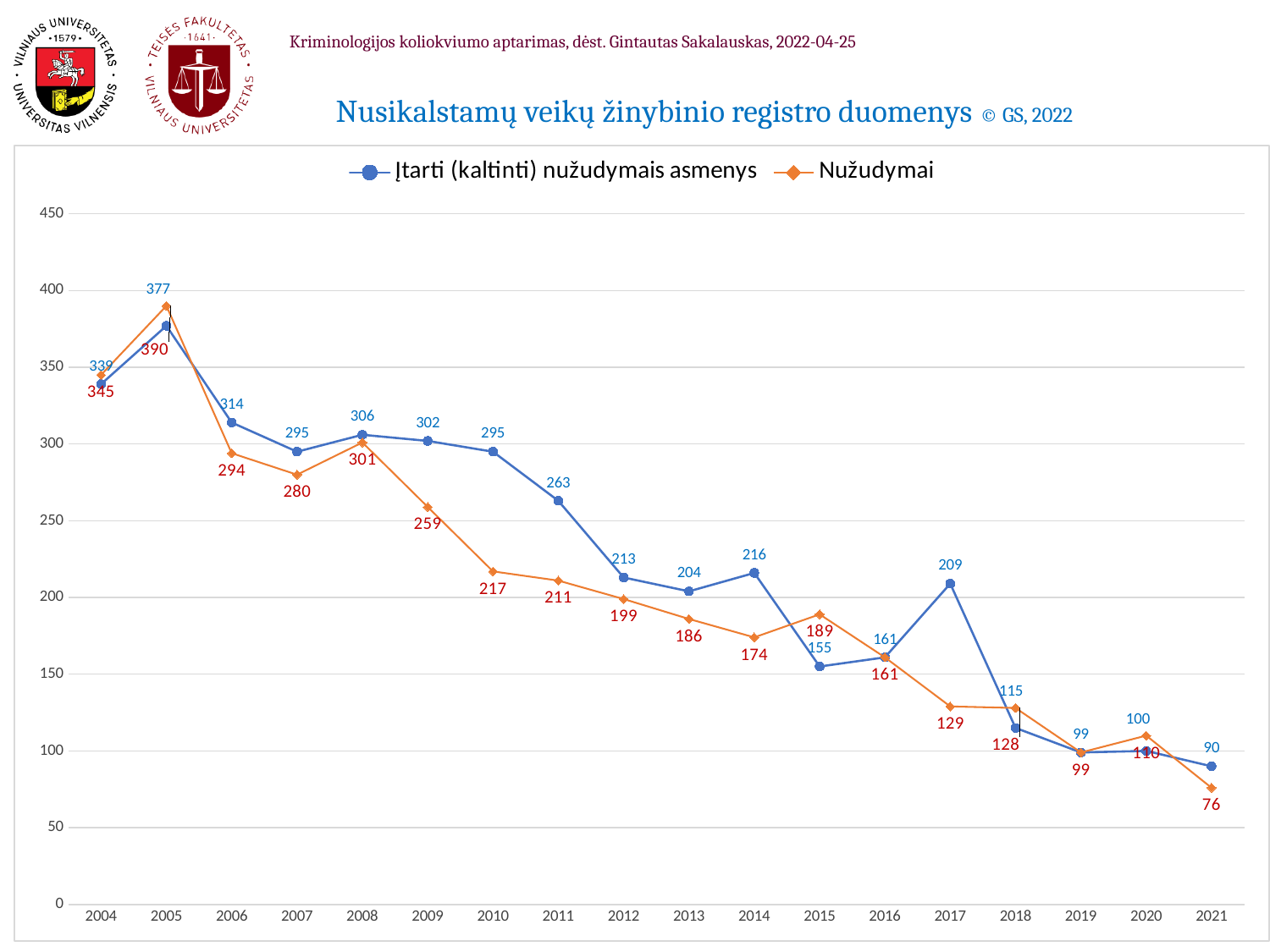
Which series has the larger value in 2015? Nužudymai What kind of chart is shown on the slide? Line chart How many series does the legend list? 2 Overall, do the values of the Nužudymai series rise or fall from 2005 to 2021? Fall How many years are shown on the x axis? 18 What is the value of the Įtarti (kaltinti) nužudymais asmenys series in 2017? 209 What is the value of the Nužudymai series in 2005? 390 What is the difference between the Įtarti (kaltinti) nužudymais asmenys value and the Nužudymai value in 2017? 80 In which year does the Nužudymai series reach its highest value? 2005 Is the value of the Nužudymai series in 2009 greater or less than 250? greater In which year is the Įtarti (kaltinti) nužudymais asmenys series at its lowest? 2021 What is the value of the Nužudymai series in 2021? 76